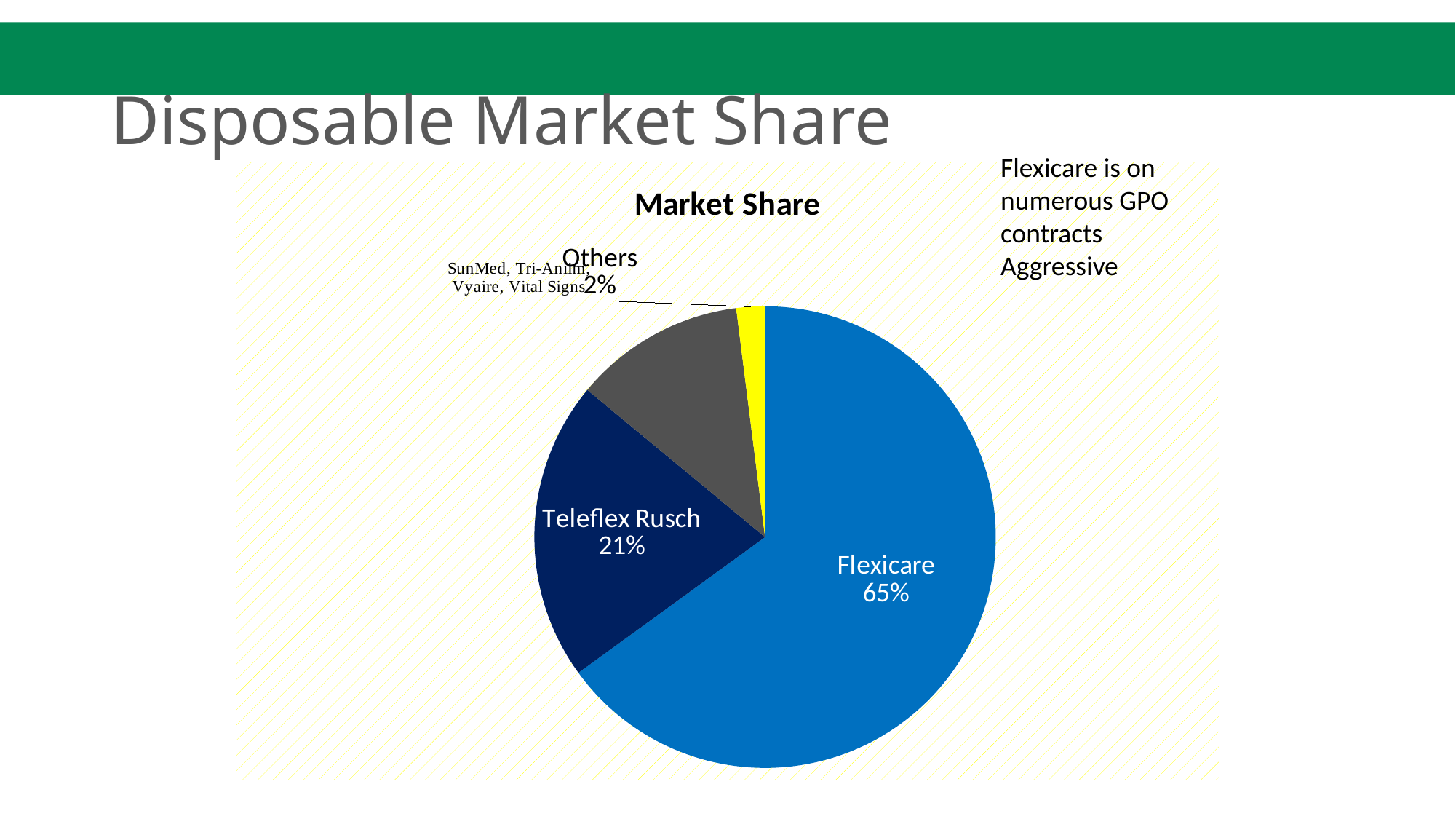
What is the market share shown for Flexicare? 65% How many slices does the pie chart have? 4 Which company has the largest slice of the pie chart? Flexicare Which has a larger share, Teleflex Rusch or the SunMed, Tri-Anim, Vyaire, Vital Signs slice? Teleflex Rusch What is the market share shown for Teleflex Rusch? 21% What kind of chart is shown on the slide? Pie chart What is the market share shown for Others? 2% What is the title of the chart? Market Share What colour is the Others slice of the pie chart? Yellow Which slice of the pie chart is the smallest? Others How many percentage points larger is Teleflex Rusch's share than the Others share? 19 percentage points How many percentage points larger is Flexicare's share than Teleflex Rusch's share? 44 percentage points